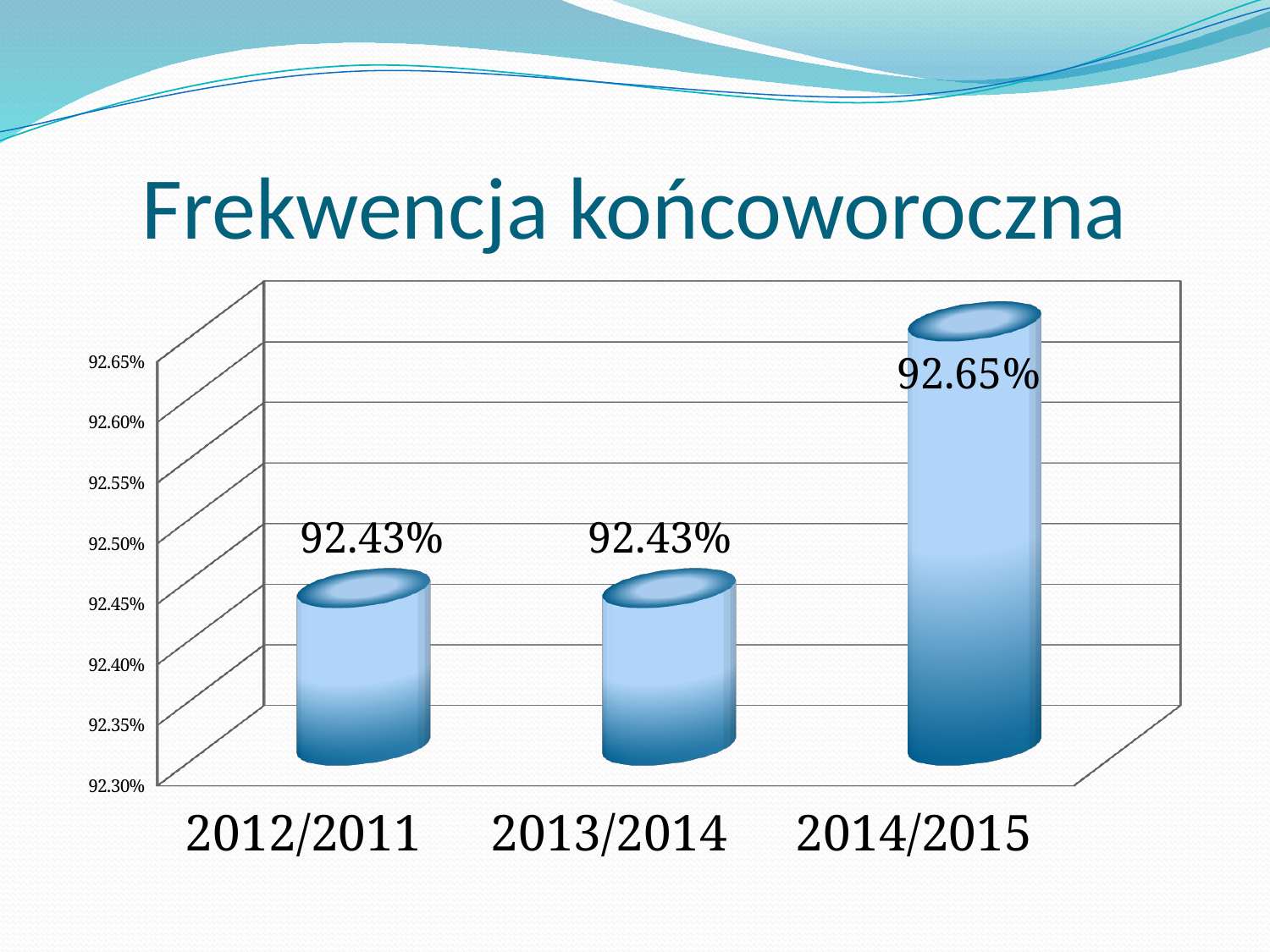
Which category has the highest value? 2014/2015 What kind of chart is shown on the slide? bar chart Do the values rise or fall from 2013/2014 to 2014/2015? rise What is the value for 2014/2015? 92.65% How many categories are shown on the x axis? 3 Is the value for 2014/2015 greater or less than 92.60%? greater What is the title of the slide? Frekwencja końcoworoczna Is the value for 2012/2011 greater or less than 92.50%? less What is the value for 2013/2014? 92.43% Which is larger, the value for 2014/2015 or the value for 2012/2011? 2014/2015 What is the value for 2012/2011? 92.43% What is the difference between the values for 2014/2015 and 2013/2014? 0.22%